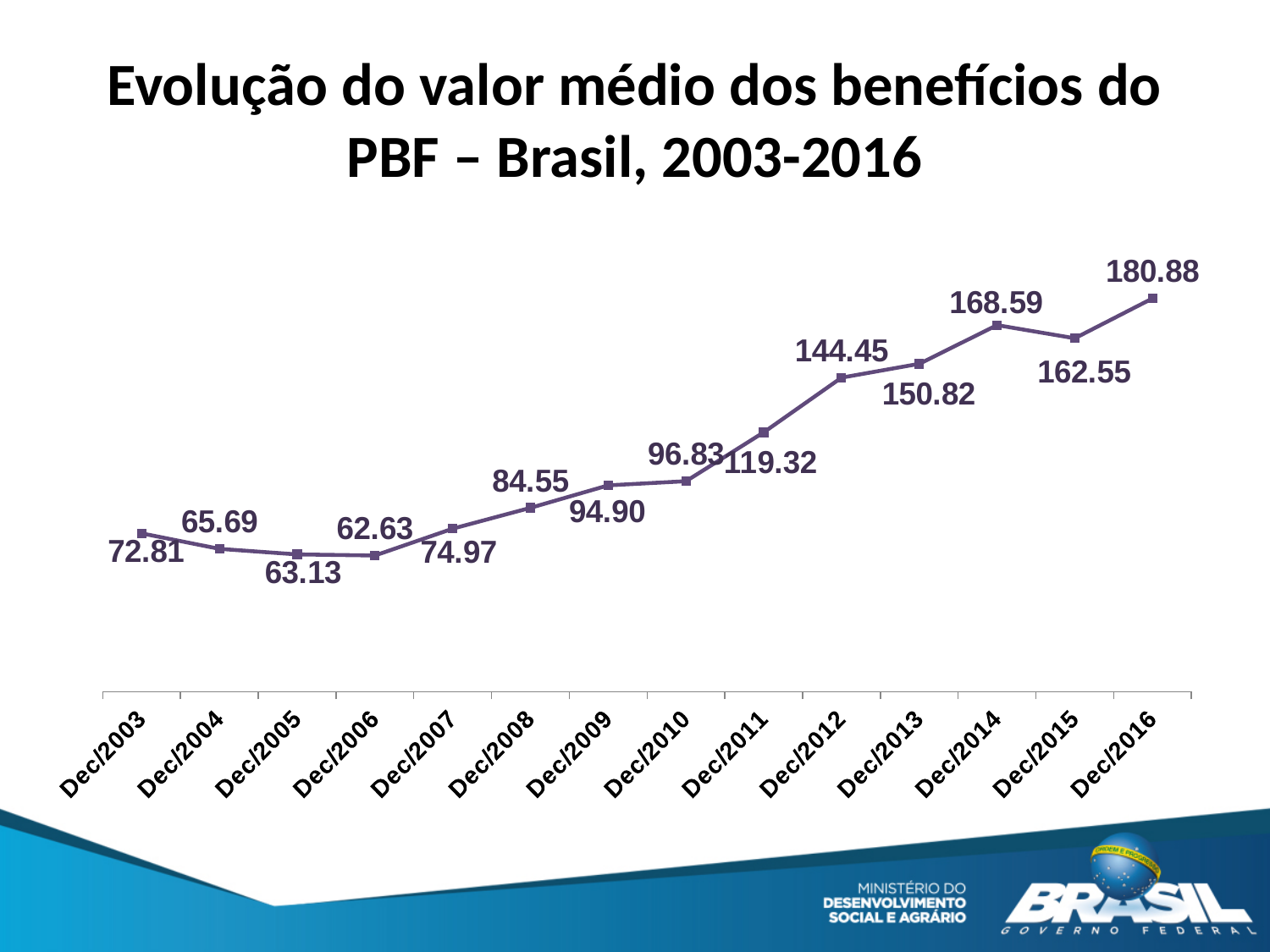
How many data points are plotted on the chart? 14 What is the value for Dec/2016? 180.88 What kind of chart is shown on the slide? Line chart What is the value for Dec/2003? 72.81 What is the difference between the values for Dec/2016 and Dec/2003? 108.07 Which is larger, the value for Dec/2003 or the value for Dec/2007? Dec/2007 Which is larger, the value for Dec/2014 or the value for Dec/2015? Dec/2014 Which point has the lowest value? Dec/2006 What is the value for Dec/2011? 119.32 Do the values generally rise or fall from Dec/2006 to Dec/2016? Rise What is the difference between the values for Dec/2014 and Dec/2015? 6.04 Which point has the highest value? Dec/2016